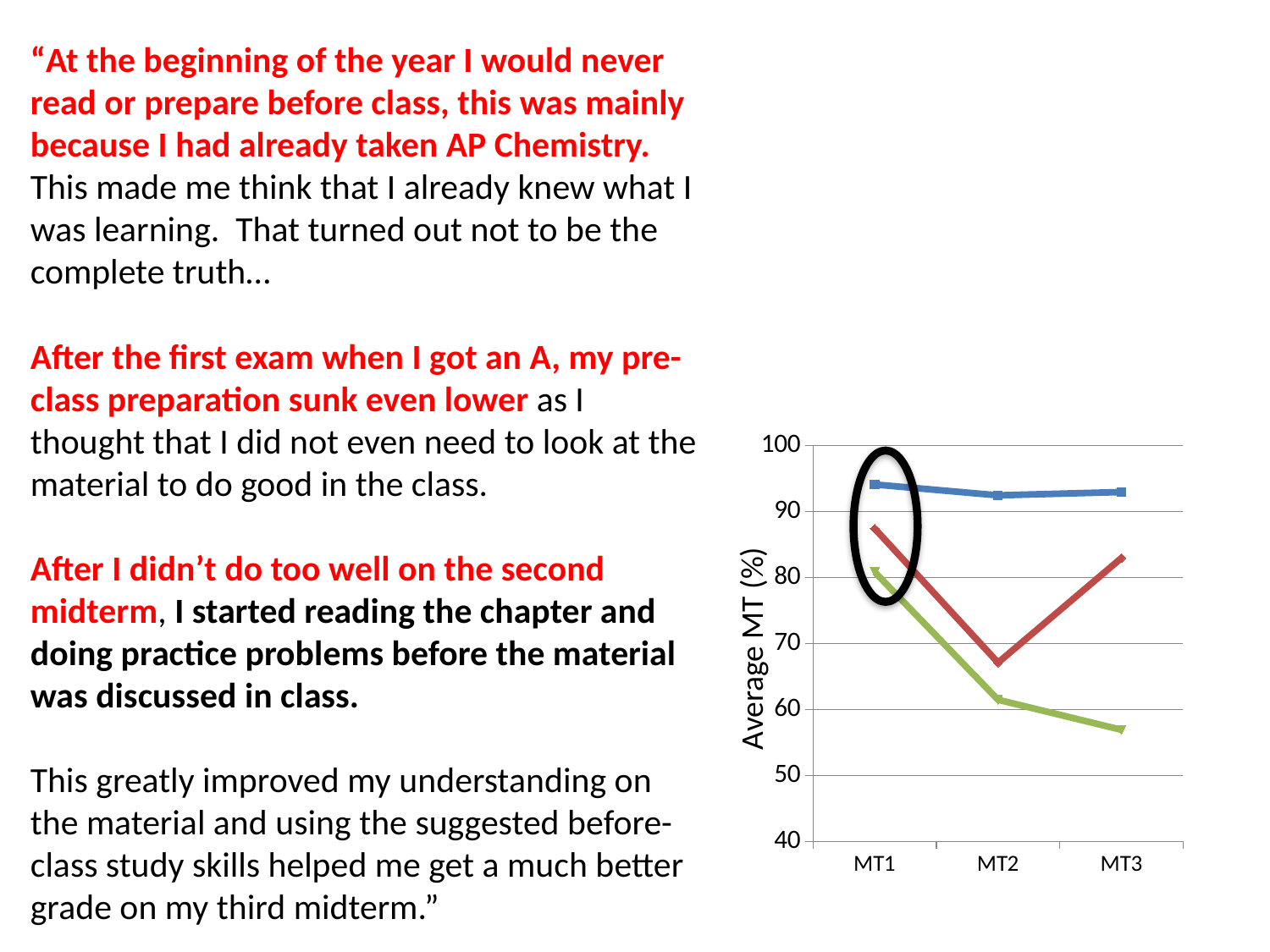
What kind of chart is shown on the slide? line chart What is the label of the y axis of the chart? Average MT (%) Which line has the lowest value at MT3? the green line How many lines are plotted on the chart? 3 Is the value of the red line at MT2 greater or less than 70? less At MT3, is the red line or the green line higher? the red line Is the value of the blue line at MT1 greater or less than 90? greater Which line has the highest value at MT2? the blue line Does the green line rise or fall from MT1 to MT3? fall Is the value of the red line at MT3 greater or less than 80? greater How many categories are shown on the x axis of the chart? 3